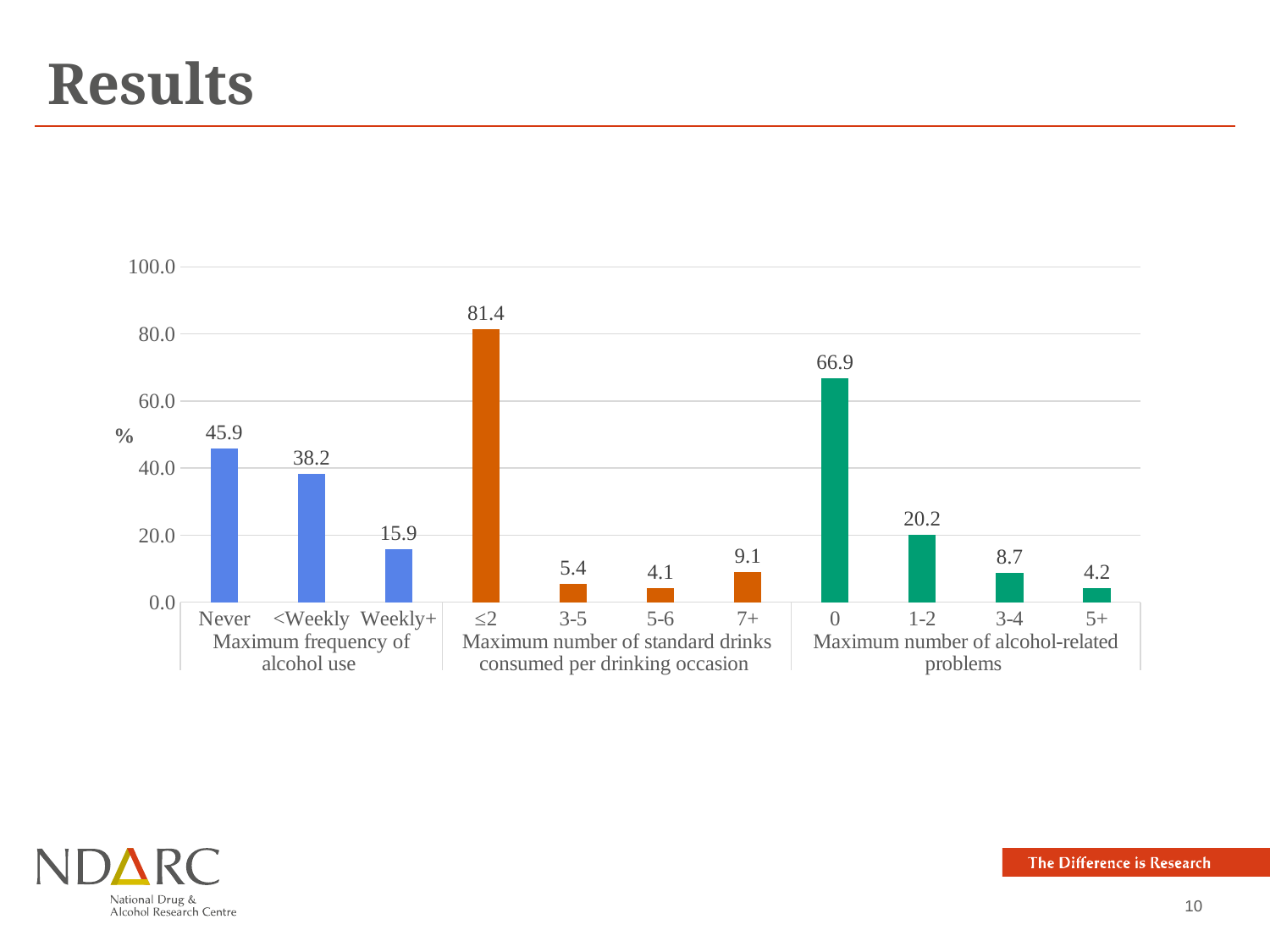
What kind of chart is shown on the slide? Bar chart Which is larger, the value for "7+" standard drinks or the value for "3-4" alcohol-related problems? 7+ What is the value for "1-2" under Maximum number of alcohol-related problems? 20.2 What is the value for "Never" under Maximum frequency of alcohol use? 45.9 What is the label on the vertical axis of the chart? % How many bars are plotted on the chart in total? 11 Which category has the lowest value on the chart? 5-6 What is the difference between the values for "Never" and "<Weekly"? 7.7 What is the value for "Weekly+" under Maximum frequency of alcohol use? 15.9 Which category has the highest value on the chart? ≤2 What is the difference between the values for "0" and "1-2" under Maximum number of alcohol-related problems? 46.7 What is the value for "≤2" under Maximum number of standard drinks consumed per drinking occasion? 81.4